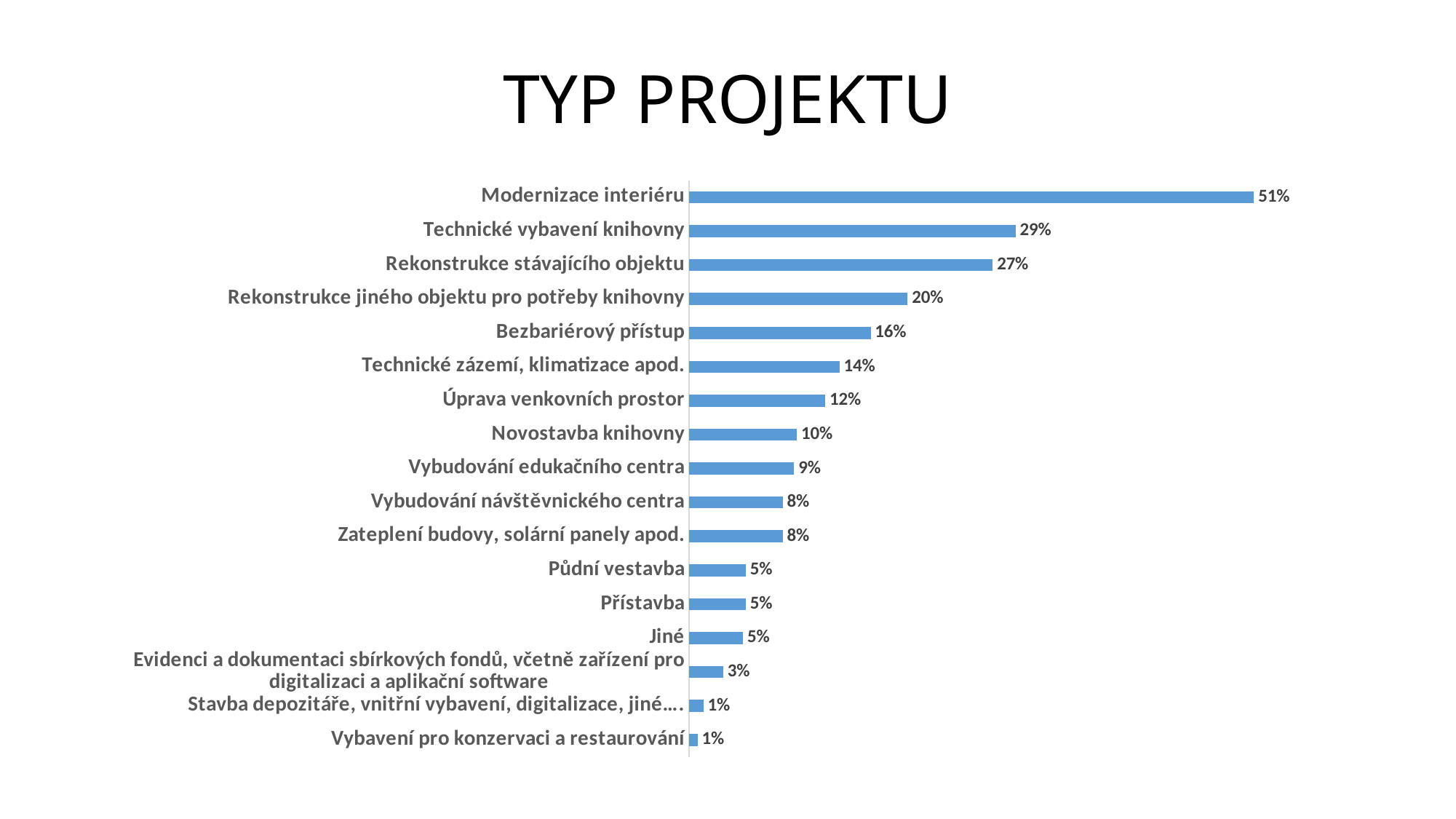
What kind of chart is shown on the slide? bar chart Which is larger, Půdní vestavba or Evidenci a dokumentaci sbírkových fondů, včetně zařízení pro digitalizaci a aplikační software? Půdní vestavba What is the value for Novostavba knihovny? 10% What is the difference between Modernizace interiéru and Rekonstrukce jiného objektu pro potřeby knihovny? 31% What is the value for Úprava venkovních prostor? 12% What is the difference between Technické vybavení knihovny and Rekonstrukce stávajícího objektu? 2% How many categories are shown in the chart? 17 What is the value for Modernizace interiéru? 51% What is the value for Bezbariérový přístup? 16% Which is larger, Technické zázemí, klimatizace apod. or Vybudování edukačního centra? Technické zázemí, klimatizace apod. Which category has the highest value? Modernizace interiéru What is the title of the slide? TYP PROJEKTU